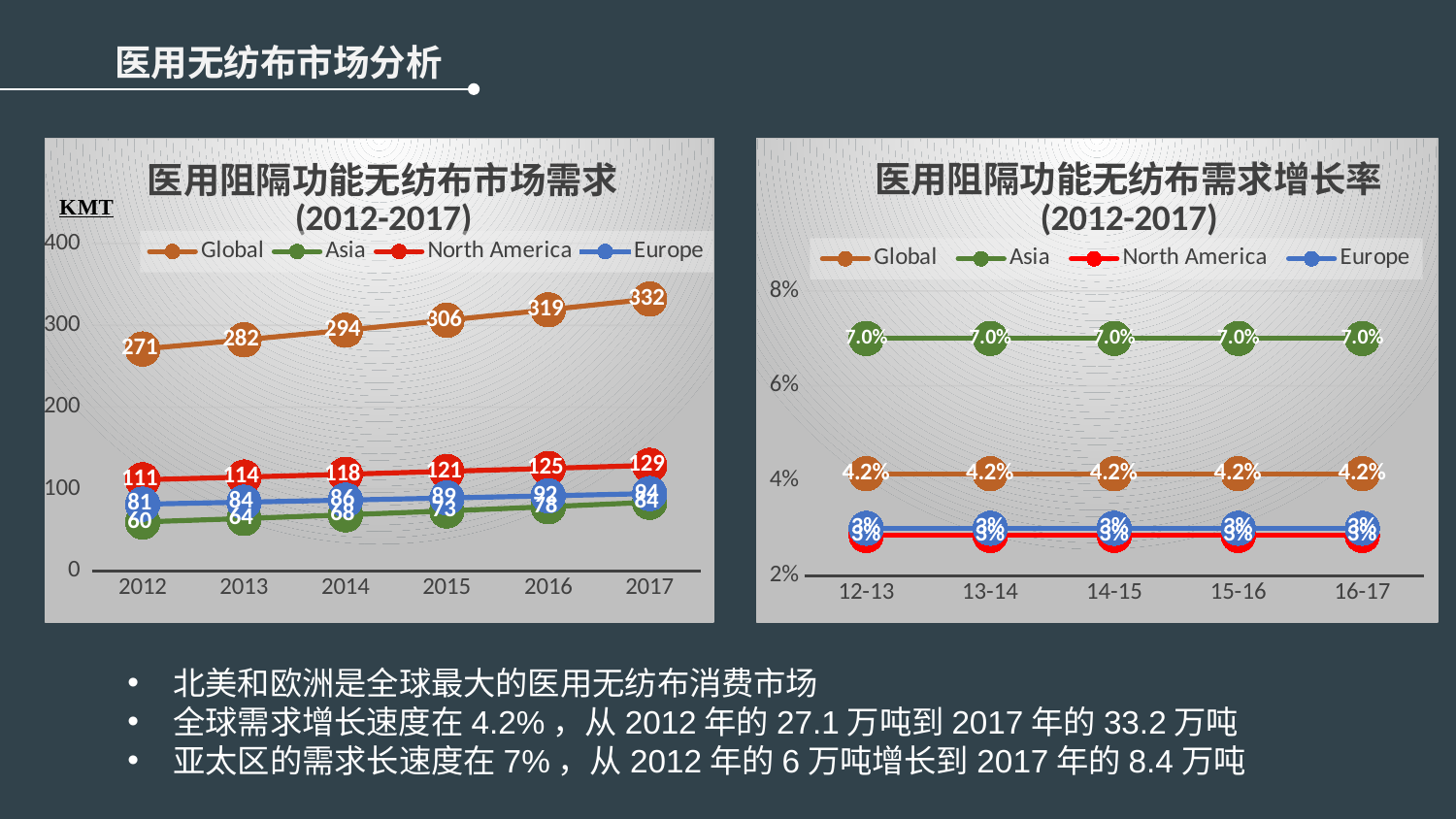
In the left chart (医用阻隔功能无纺布市场需求), what is the Asia value for 2012? 60 In the right chart (医用阻隔功能无纺布需求增长率), how many series does the legend list? 4 What kind of chart is the right chart (医用阻隔功能无纺布需求增长率)? line chart In the left chart (医用阻隔功能无纺布市场需求), what is the Global value for 2017? 332 In the left chart (医用阻隔功能无纺布市场需求), how many years are shown on the x axis? 6 In the right chart (医用阻隔功能无纺布需求增长率), what is the Global growth rate for 12-13? 4.2% In the right chart (医用阻隔功能无纺布需求增长率), what is the Asia growth rate for 16-17? 7.0% In the left chart (医用阻隔功能无纺布市场需求), does the Global series rise or fall from 2012 to 2017? rise In the left chart (医用阻隔功能无纺布市场需求), which series has the highest values across all years? Global In the left chart (医用阻隔功能无纺布市场需求), what is the North America value for 2014? 118 In the left chart (医用阻隔功能无纺布市场需求), which is larger in 2013: North America or Europe? North America In the left chart (医用阻隔功能无纺布市场需求), by how much did the Global value increase from 2012 to 2017? 61